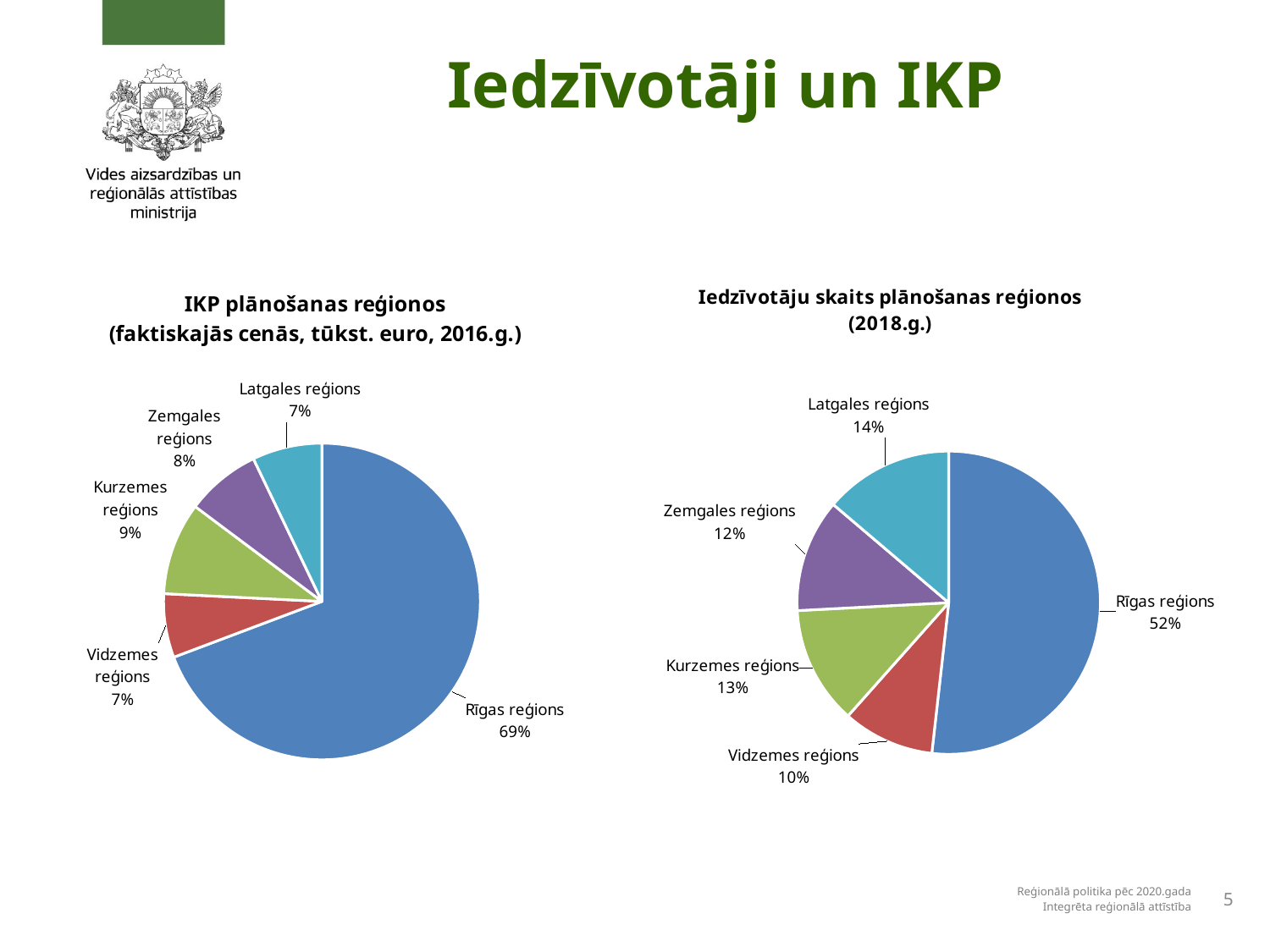
In the right chart (Iedzīvotāju skaits plānošanas reģionos), what is the share for Latgales reģions? 14% In the left chart (IKP plānošanas reģionos), what share does Rīgas reģions have? 69% What is the difference between the share of Rīgas reģions in the left chart (IKP) and in the right chart (Iedzīvotāju skaits)? 17 percentage points What year is given in the title of the right chart (Iedzīvotāju skaits plānošanas reģionos)? 2018.g. How many slices does the right chart (Iedzīvotāju skaits plānošanas reģionos) have? 5 In the right chart (Iedzīvotāju skaits plānošanas reģionos), what share does Rīgas reģions have? 52% In the right chart (Iedzīvotāju skaits plānošanas reģionos), what is the difference between the shares of Rīgas reģions and Latgales reģions? 38 percentage points In the left chart (IKP plānošanas reģionos), which region has the largest share? Rīgas reģions In the right chart (Iedzīvotāju skaits plānošanas reģionos), which region has the smallest share? Vidzemes reģions What type of chart is the left chart (IKP plānošanas reģionos)? Pie chart In the left chart (IKP plānošanas reģionos), which is larger: the share of Kurzemes reģions or Zemgales reģions? Kurzemes reģions In the left chart (IKP plānošanas reģionos), what is the share for Kurzemes reģions? 9%